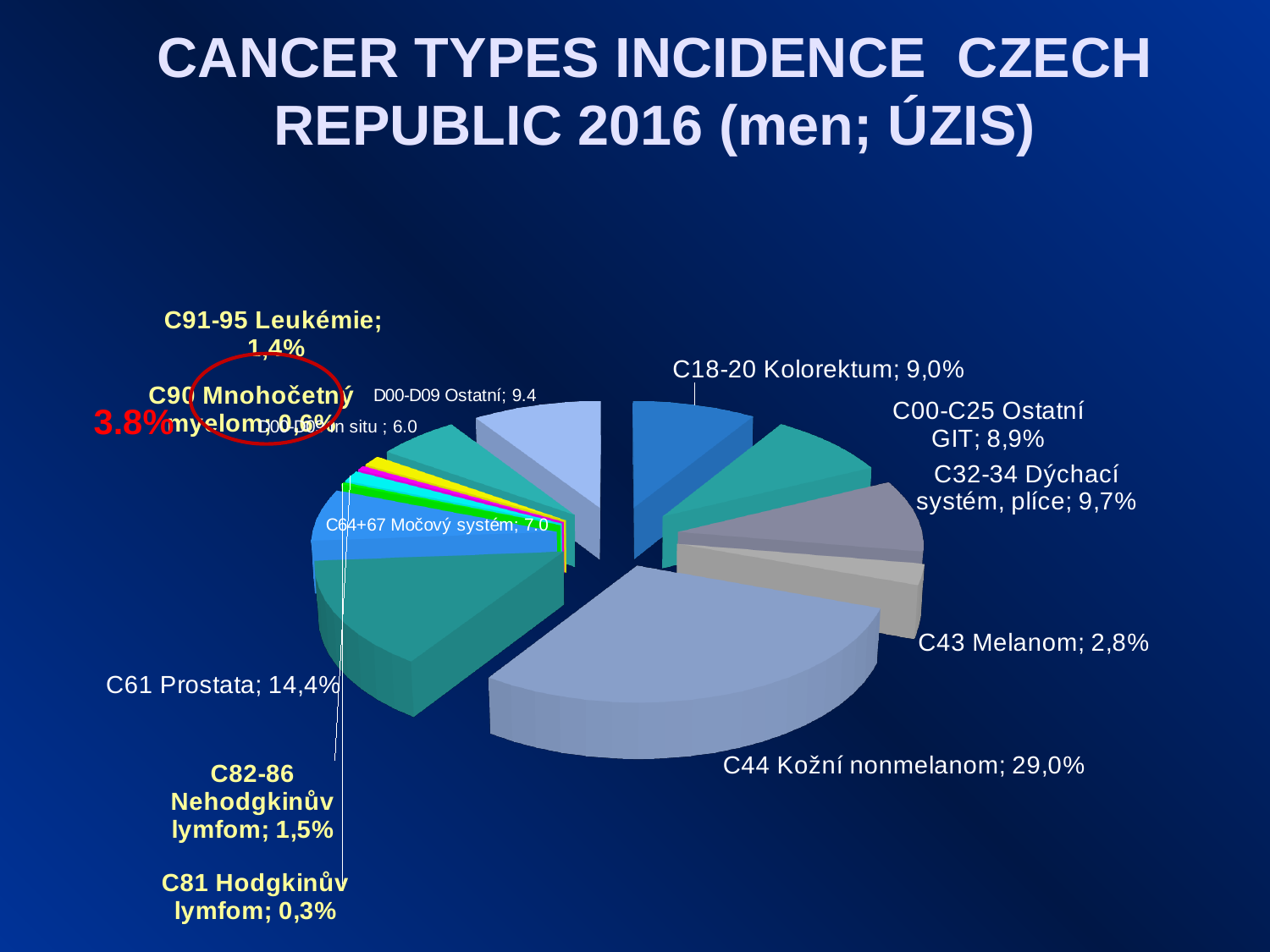
What kind of chart is shown on the slide? pie chart What is the share for C44 Kožní nonmelanom? 29,0% What is the share for C43 Melanom? 2,8% What is the difference in percentage points between C61 Prostata and C18-20 Kolorektum? 5,4 What is the title of the slide? CANCER TYPES INCIDENCE CZECH REPUBLIC 2016 (men; ÚZIS) What is the share for C82-86 Nehodgkinův lymfom? 1,5% What is the share for C32-34 Dýchací systém, plíce? 9,7% Which category has the smallest share of the pie? C81 Hodgkinův lymfom Which category has the largest share of the pie? C44 Kožní nonmelanom What is the share for C61 Prostata? 14,4% Which is larger, the share for C91-95 Leukémie or the share for C82-86 Nehodgkinův lymfom? C82-86 Nehodgkinův lymfom Which is larger, the share for C18-20 Kolorektum or the share for C00-C25 Ostatní GIT? C18-20 Kolorektum